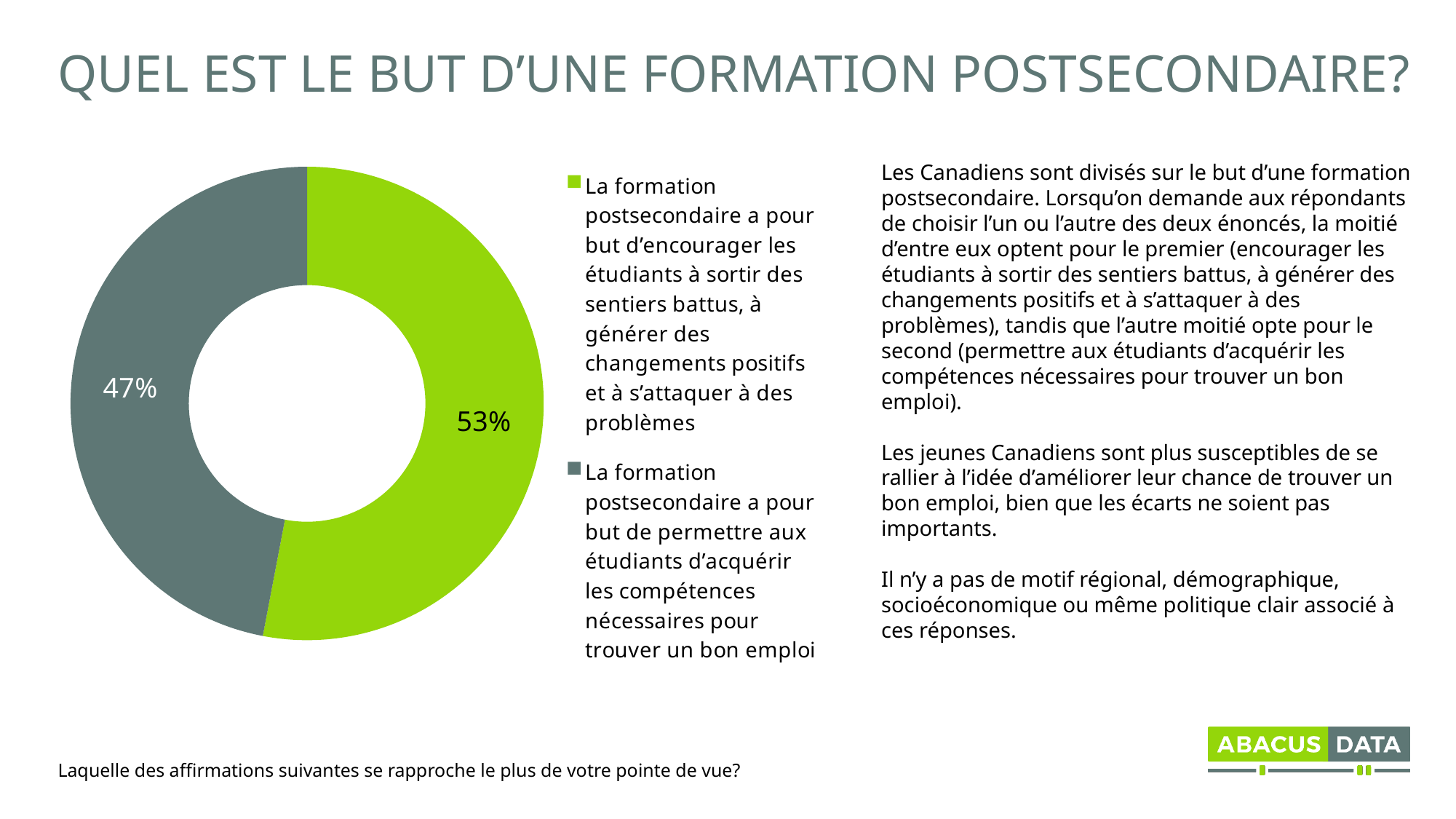
What kind of chart is shown on the slide? Doughnut (pie) chart How many slices does the chart have? 2 Is the green slice larger or smaller than the grey slice? larger Is the share for the 'trouver un bon emploi' statement greater or less than 50%? less Which statement received the larger share of responses? La formation postsecondaire a pour but d'encourager les étudiants à sortir des sentiers battus, à générer des changements positifs et à s'attaquer à des problèmes What share of respondents chose the statement that postsecondary education should encourage students to think outside the box, generate positive change and tackle problems? 53% What share of respondents chose the statement that postsecondary education should allow students to acquire the skills needed to find a good job? 47% How many entries does the legend list? 2 What is the difference in percentage points between the two slices of the chart? 6 Which statement received the smaller share of responses? La formation postsecondaire a pour but de permettre aux étudiants d'acquérir les compétences nécessaires pour trouver un bon emploi What is the survey question shown at the bottom of the slide? Laquelle des affirmations suivantes se rapproche le plus de votre pointe de vue? What colour is the slice representing 47%? Grey